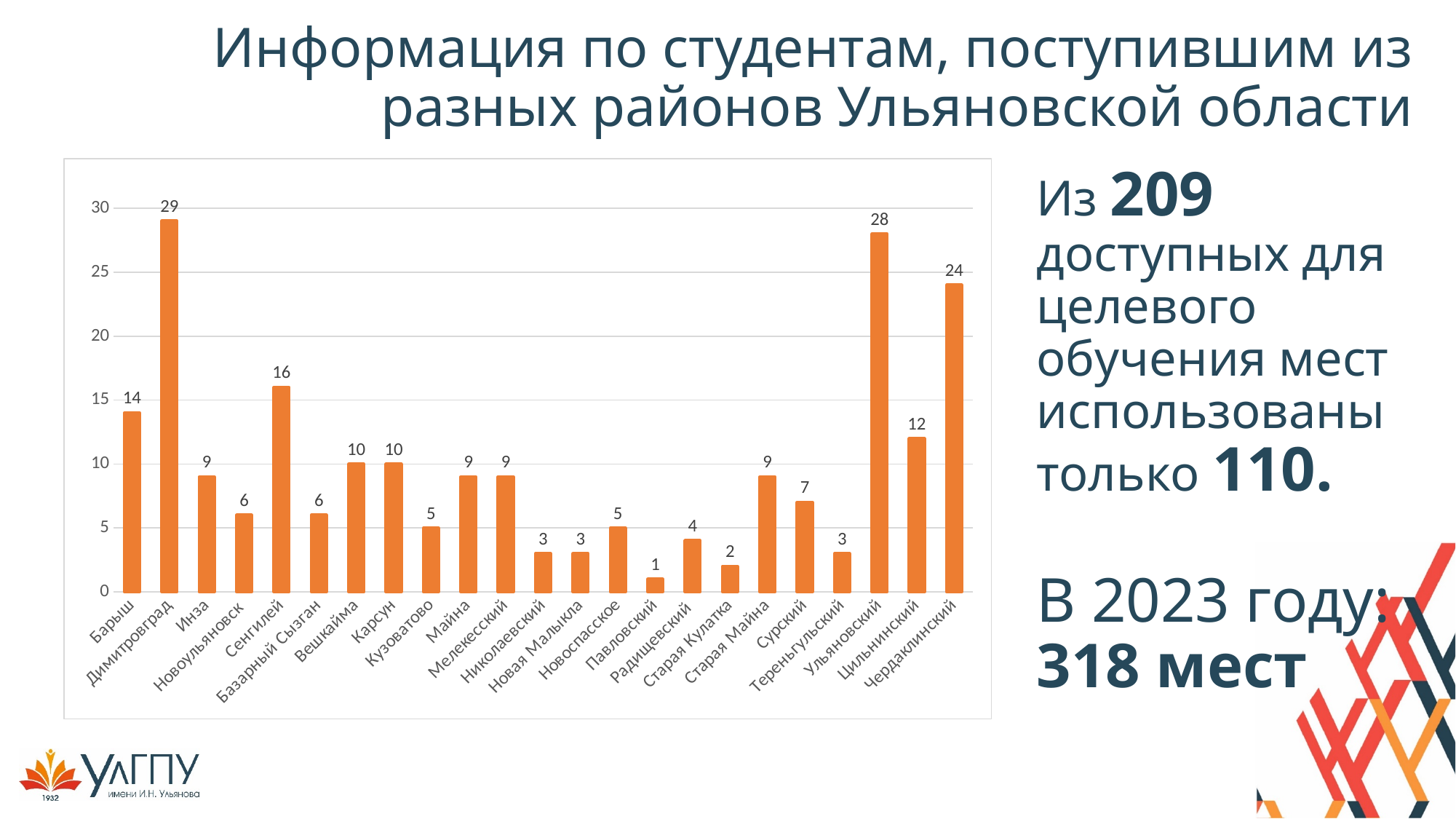
What colour are the bars in the chart? orange What kind of chart is shown on the slide? bar chart Which category has the highest value? Димитровград What is the difference between the values for Димитровград and Чердаклинский? 5 Which category has the lowest value? Павловский Which is larger, the value for Барыш or the value for Цильнинский? Барыш Is the value for Чердаклинский greater or less than 20? greater What is the value for Ульяновский? 28 What is the value for Цильнинский? 12 How many categories are shown on the x axis? 23 What is the value for Сенгилей? 16 What is the value for Димитровград? 29